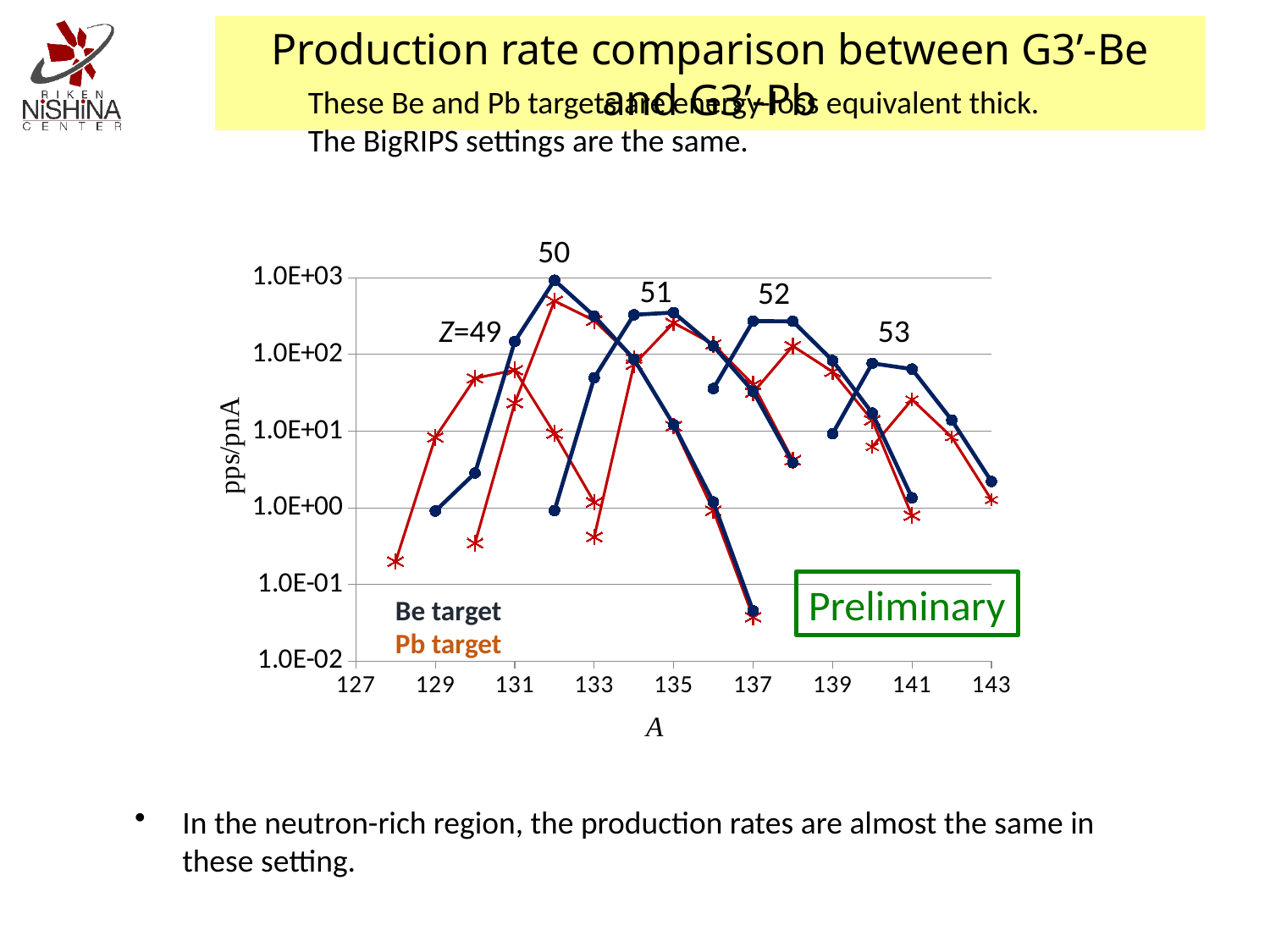
What are the two series named in the chart legend? Be target and Pb target What is the highest tick value shown on the y-axis of the chart? 1.0E+03 Which Z chain reaches the highest production rate on the chart? Z=50 What is the label of the y-axis of the chart? pps/pnA Is the Pb target value at A=128 greater or less than 1.0E+00? less What kind of chart is shown on the slide? line chart Is the Be target value at A=137 for the Z=50 chain greater or less than 1.0E-01? less How many series does the chart's legend list? 2 Is the Pb target value at A=132 for the Z=50 chain greater or less than 1.0E+02? greater How many Z values (isotope chains) are labeled on the chart? 5